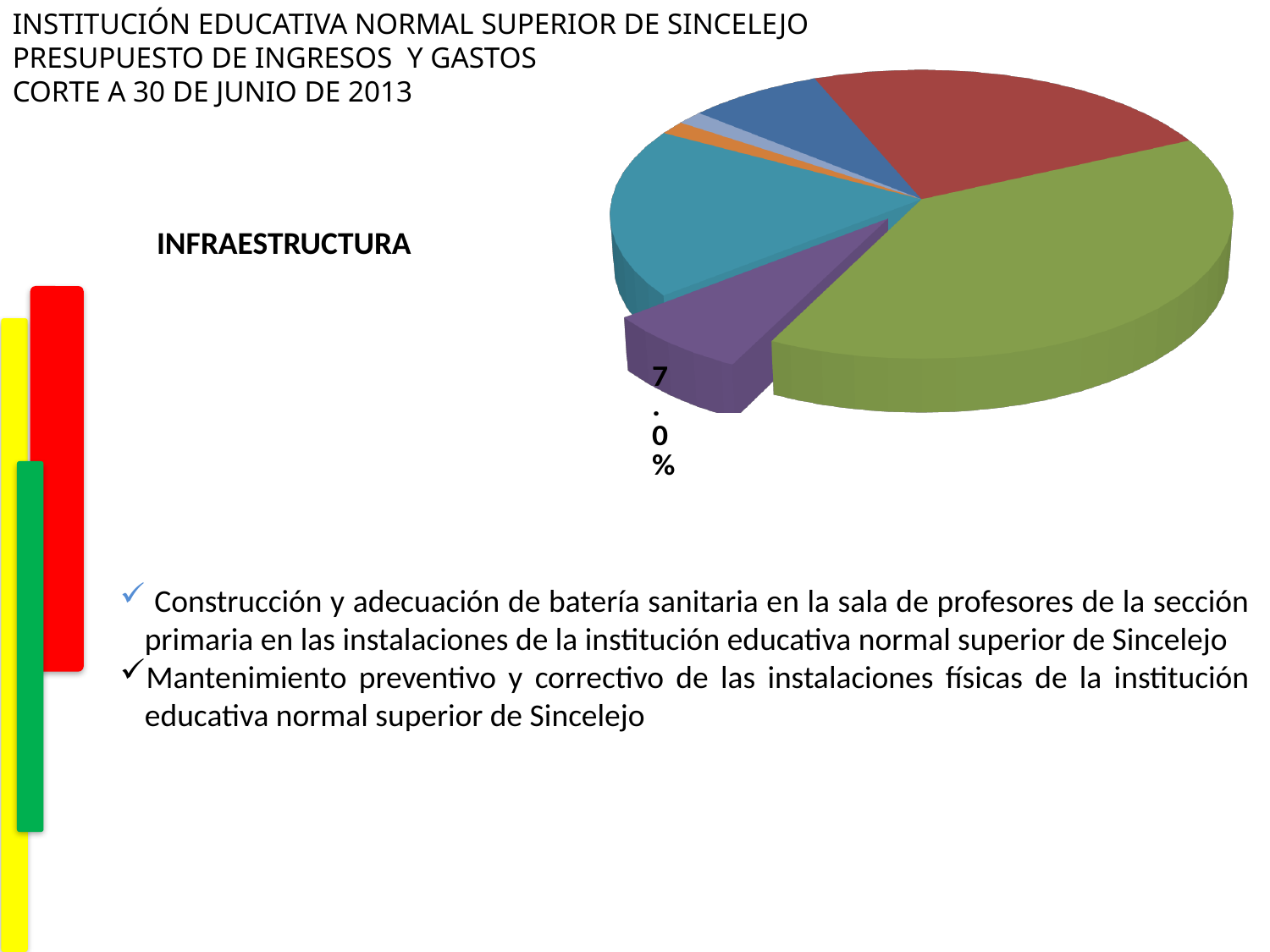
Which is larger in the pie chart, the red slice or the orange slice? the red slice Which is larger in the pie chart, the green slice or the purple slice? the green slice Does the pie chart display a legend? No What percentage is printed on the exploded (pulled-out) purple slice of the pie chart? 7.0% What kind of chart is shown on the slide? pie chart Which colour slice is the largest in the pie chart? green Which colour slice is pulled out from the rest of the pie chart? purple How many slices does the pie chart have? 7 Is the share of the exploded purple slice greater or less than 10%? less